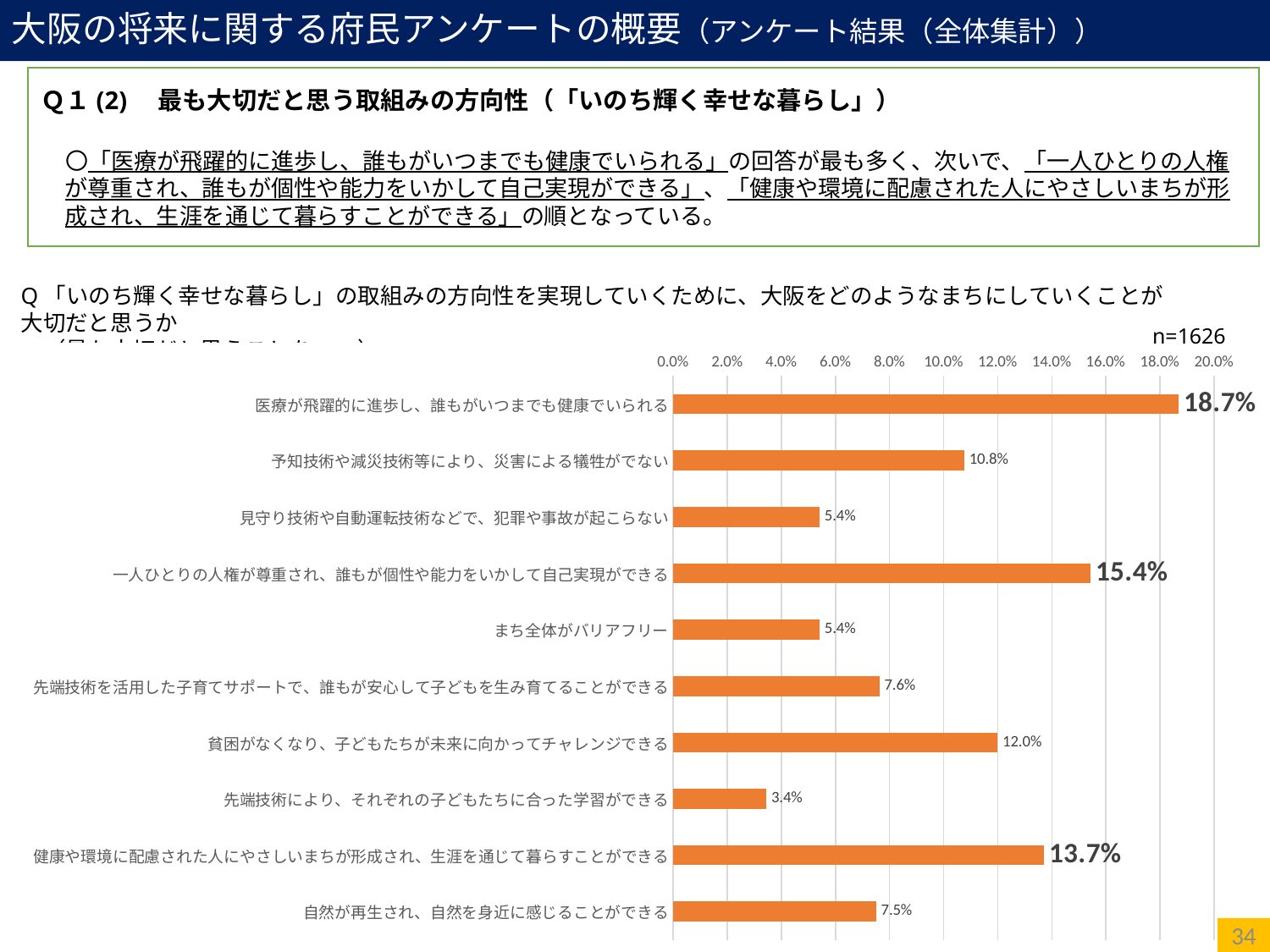
Is the value for 先端技術を活用した子育てサポートで、誰もが安心して子どもを生み育てることができる greater or less than 10.0%? less What is the value for 医療が飛躍的に進歩し、誰もがいつまでも健康でいられる? 18.7% How many categories are shown in the chart? 10 What is the value for 自然が再生され、自然を身近に感じることができる? 7.5% Which category has the highest value? 医療が飛躍的に進歩し、誰もがいつまでも健康でいられる Which category has the lowest value? 先端技術により、それぞれの子どもたちに合った学習ができる What kind of chart is shown on the slide? bar chart What is the sample size (n) shown above the chart? n=1626 What is the difference between the values for 一人ひとりの人権が尊重され、誰もが個性や能力をいかして自己実現ができる and 健康や環境に配慮された人にやさしいまちが形成され、生涯を通じて暮らすことができる? 1.7% What is the value for 貧困がなくなり、子どもたちが未来に向かってチャレンジできる? 12.0% What is the value for まち全体がバリアフリー? 5.4% Which is larger: the value for 予知技術や減災技術等により、災害による犠牲がでない or the value for 貧困がなくなり、子どもたちが未来に向かってチャレンジできる? 貧困がなくなり、子どもたちが未来に向かってチャレンジできる